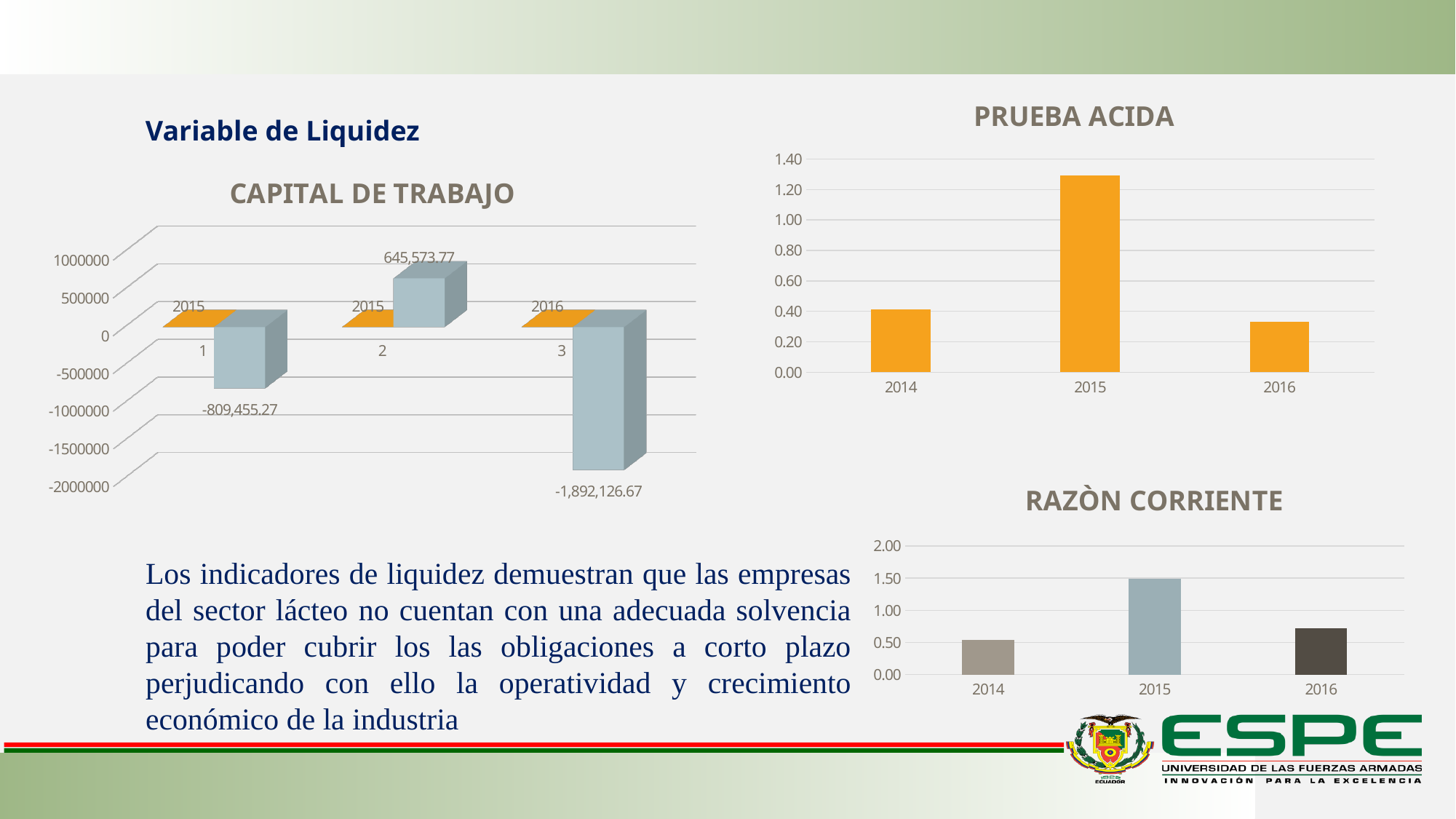
In the RAZÒN CORRIENTE chart, is the value for 2016 greater or less than 1.00? less In the CAPITAL DE TRABAJO chart, what is the value shown for category 2? 645,573.77 In the PRUEBA ACIDA chart, which year has the lowest value? 2016 In the CAPITAL DE TRABAJO chart, what is the value shown for category 3? -1,892,126.67 In the PRUEBA ACIDA chart, which year has the highest value? 2015 In the CAPITAL DE TRABAJO chart, which category has the highest value? 2 How many years are shown on the x axis of the RAZÒN CORRIENTE chart? 3 In the CAPITAL DE TRABAJO chart, which category has the lowest value? 3 In the PRUEBA ACIDA chart, is the value for 2015 greater or less than 1.20? greater In the PRUEBA ACIDA chart, is the value for 2014 greater or less than 0.60? less In the RAZÒN CORRIENTE chart, which year has the highest value? 2015 In the CAPITAL DE TRABAJO chart, what is the value shown for category 1? -809,455.27